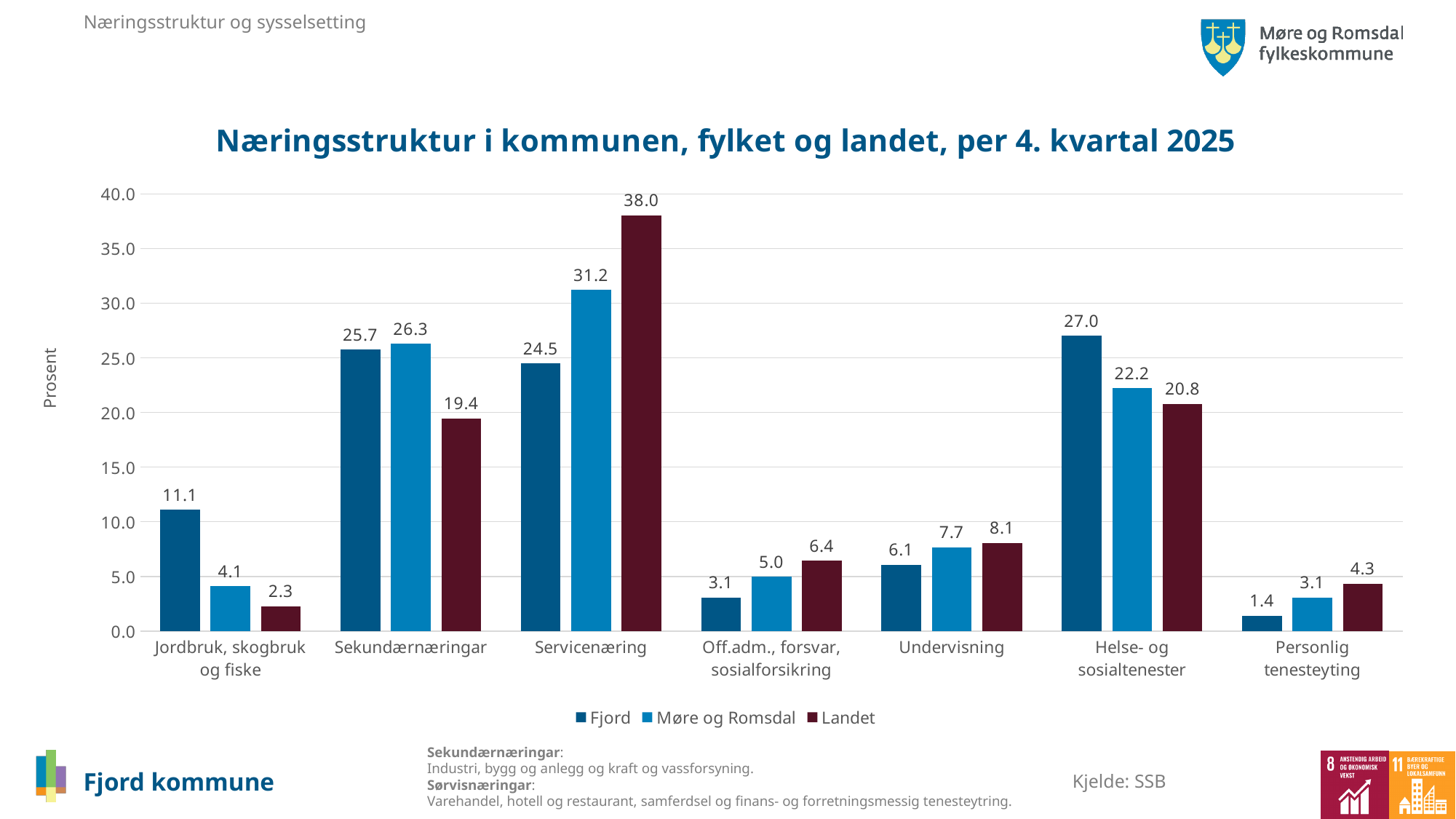
Which is larger in the Jordbruk, skogbruk og fiske category: Fjord or Landet? Fjord Which category has the lowest value for Fjord? Personlig tenesteyting What is the value for Landet in the Helse- og sosialtenester category? 20.8 How many categories are shown on the x axis? 7 What is the difference between the Landet and Fjord values for Servicenæring? 13.5 What is the value for Fjord in the Servicenæring category? 24.5 Is the value for Møre og Romsdal in Sekundærnæringar greater or less than 25.0? greater How many series does the legend list? 3 What is the value for Møre og Romsdal in the Undervisning category? 7.7 What kind of chart is shown on the slide? Bar chart Which category has the highest value for Landet? Servicenæring What is the title of the chart? Næringsstruktur i kommunen, fylket og landet, per 4. kvartal 2025